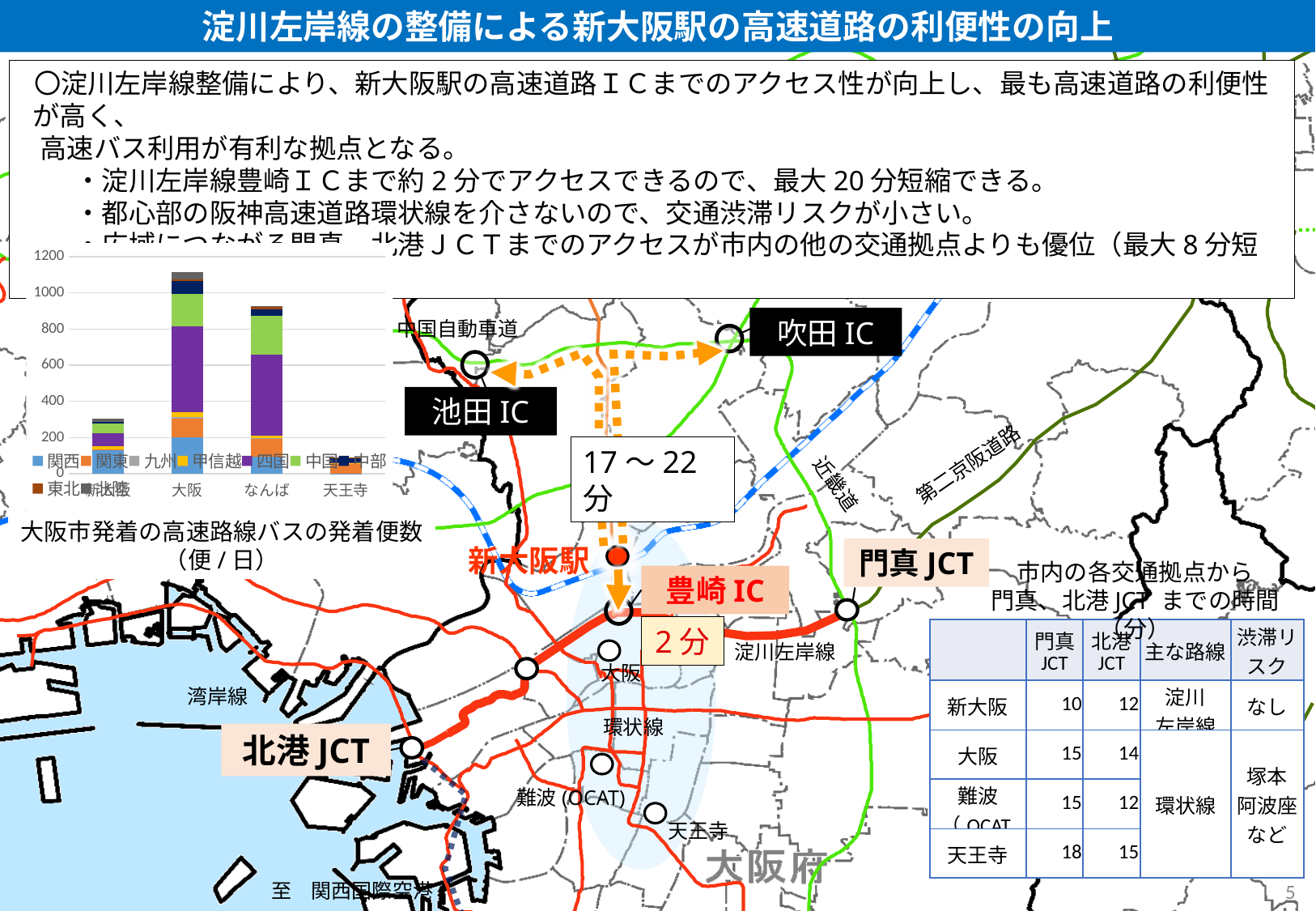
Is the total value for なんば greater or less than 800? greater Is the total value for 新大阪 greater or less than 400? less Which station has the highest total number of bus departures/arrivals in the bar chart? 大阪 What is the title of the bar chart? 大阪市発着の高速路線バスの発着便数（便/日） How many categories (stations) are shown on the x axis of the bar chart? 4 Which has a larger total in the bar chart, 新大阪 or 天王寺? 新大阪 Is the total value for 天王寺 greater or less than 200? less What is the highest tick value shown on the y axis of the bar chart? 1200 Which has a larger total in the bar chart, 大阪 or なんば? 大阪 What kind of chart is shown on the slide? bar chart Which station has the lowest total number of bus departures/arrivals in the bar chart? 天王寺